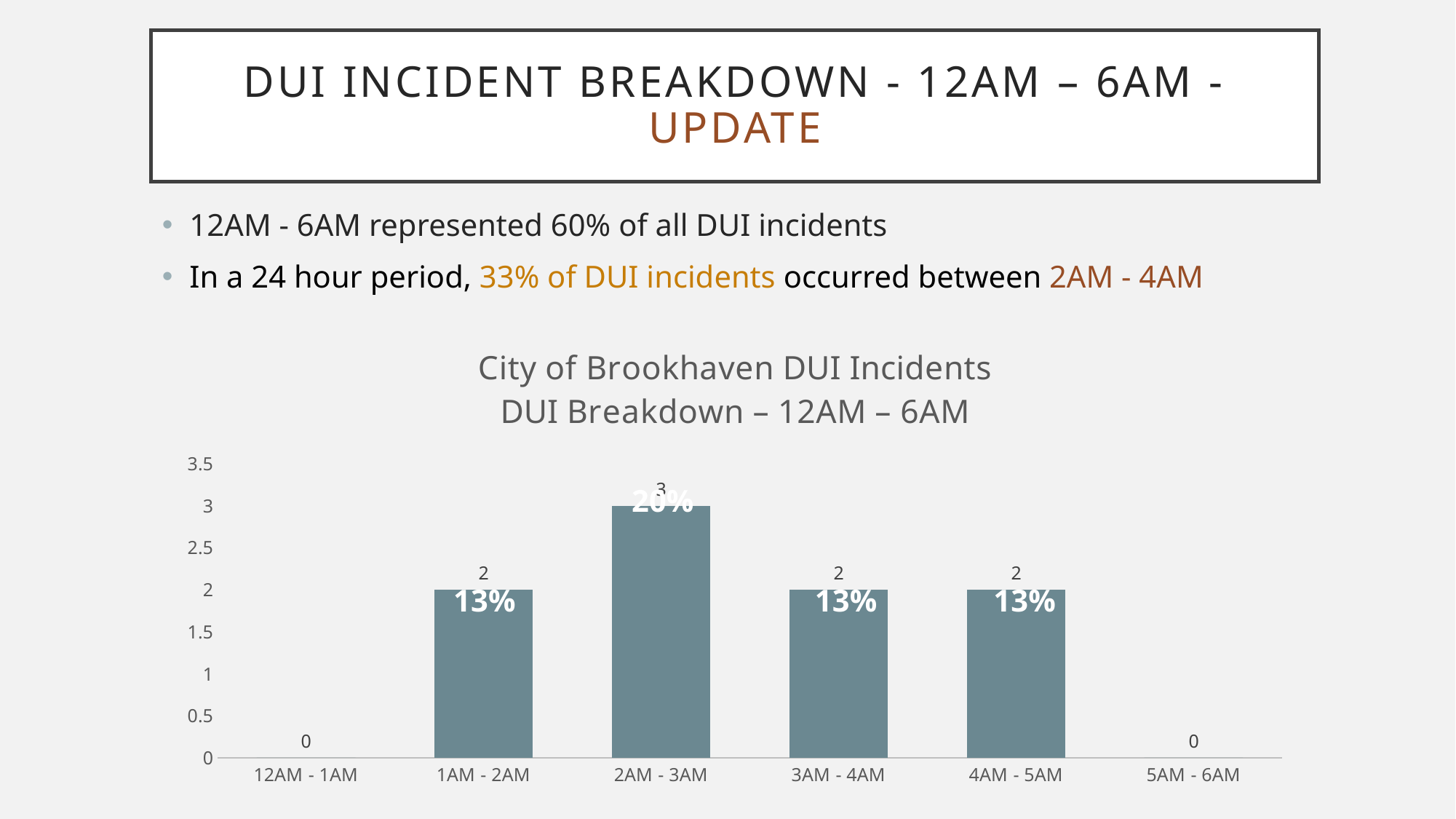
What is the value for 2AM - 3AM? 3 How many time periods have a value of 0? 2 What is the value for 1AM - 2AM? 2 What is the title of the chart? City of Brookhaven DUI Incidents DUI Breakdown – 12AM – 6AM What percentage label is shown on the 3AM - 4AM bar? 13% What percentage label is shown on the 2AM - 3AM bar? 20% What kind of chart is shown on the slide? Bar chart Which is larger, the value for 2AM - 3AM or the value for 4AM - 5AM? 2AM - 3AM What is the value for 5AM - 6AM? 0 What is the difference between the values for 2AM - 3AM and 3AM - 4AM? 1 How many time periods are shown on the x axis? 6 Which time period has the highest number of DUI incidents? 2AM - 3AM